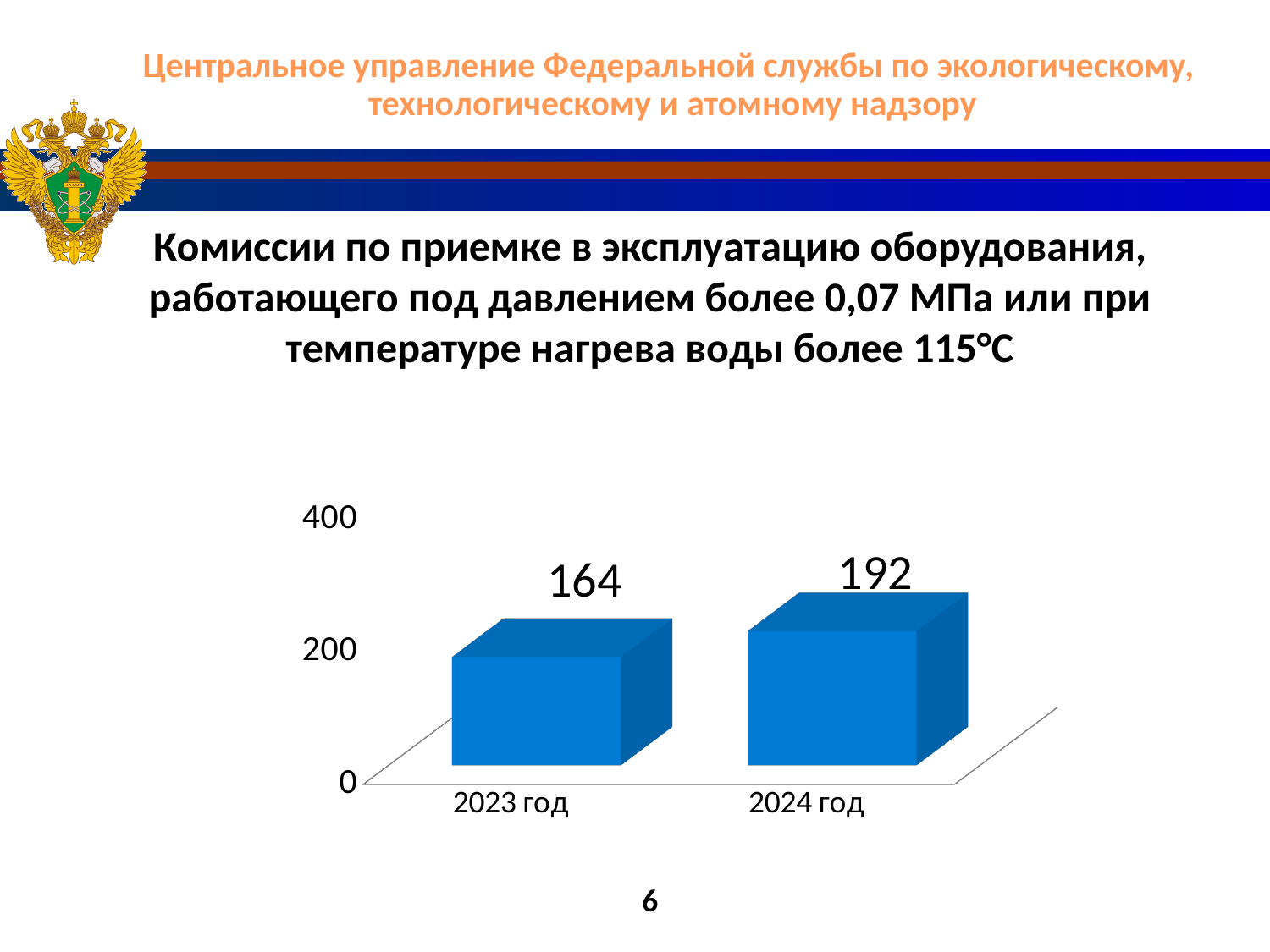
What is the difference between the values for 2024 год and 2023 год? 28 How many categories are shown on the x axis? 2 Which year has the highest value? 2024 год Which year has the lowest value? 2023 год What kind of chart is shown on the slide? bar chart Do the values rise or fall from 2023 год to 2024 год? rise Is the value for 2023 год greater or less than 200? less What is the value for 2023 год? 164 What is the highest tick value shown on the vertical axis? 400 Which is larger, the value for 2023 год or the value for 2024 год? 2024 год What is the value for 2024 год? 192